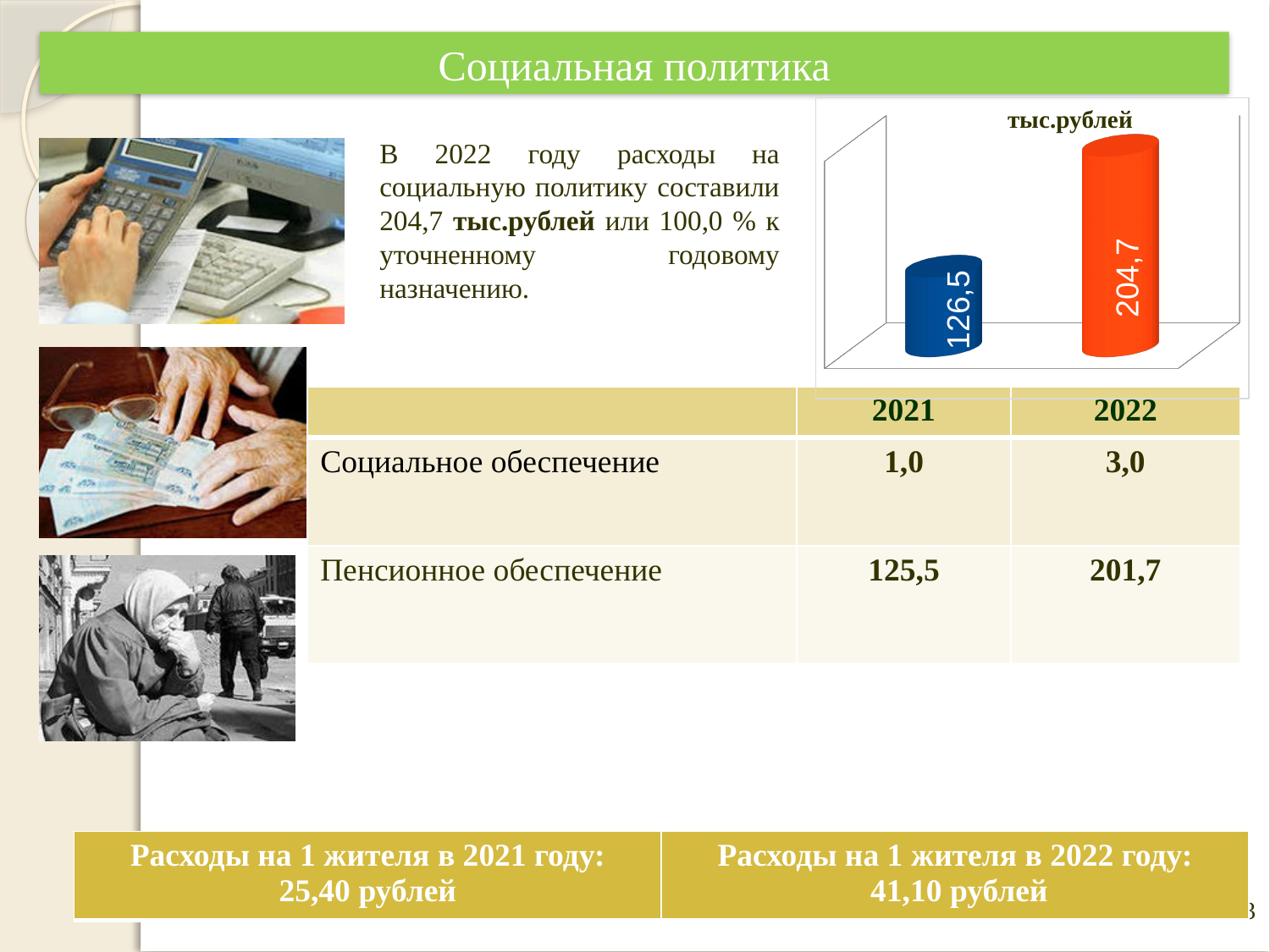
What value is printed on the blue bar in the chart? 126,5 What is the difference between the orange bar value and the blue bar value in the chart? 78,2 What unit label is shown at the top of the chart? тыс.рублей Do the values in the chart rise or fall from the left bar to the right bar? rise Which bar in the chart is the highest? the orange bar (204,7) Which bar in the chart is the lowest? the blue bar (126,5) What colour is the bar with the value 204,7? orange Which is larger in the chart: the blue bar or the orange bar? the orange bar How many bars are plotted in the chart? 2 What value is printed on the orange bar in the chart? 204,7 What type of chart is shown on the slide? bar chart What is the value of social policy expenditure for 2022 shown in the chart? 204,7